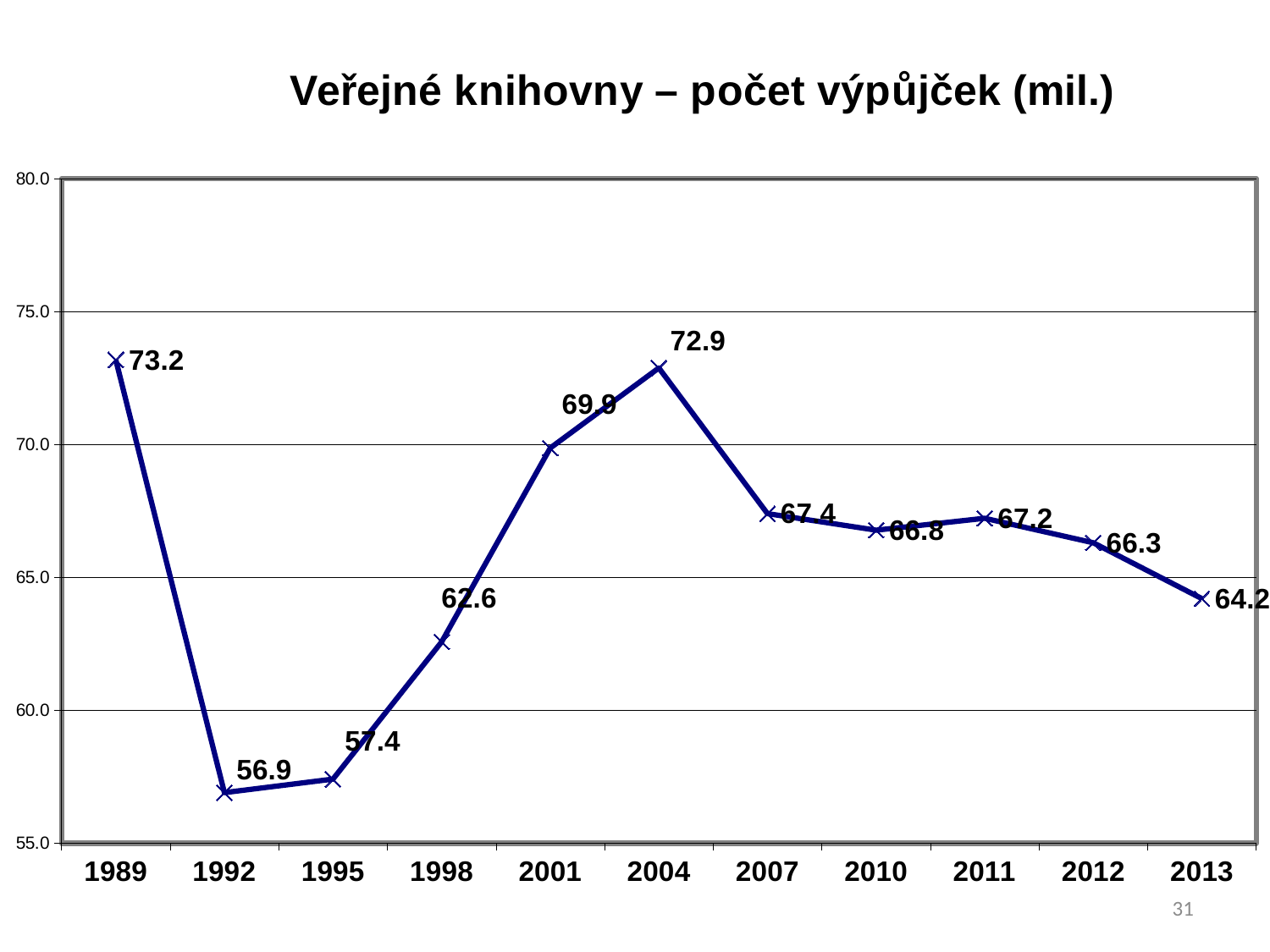
What is the value for 1989? 73.2 What is the difference between the values for 1989 and 1992? 16.3 What kind of chart is shown? line chart Which is larger, the value for 2007 or the value for 2011? 2007 What is the value for 1998? 62.6 How many years are plotted on the x axis? 11 What is the value for 2013? 64.2 What is the title of the chart? Veřejné knihovny – počet výpůjček (mil.) What is the value for 2004? 72.9 Is the value for 2001 greater or less than 65.0? greater Which year has the lowest value? 1992 Which year has the highest value? 1989